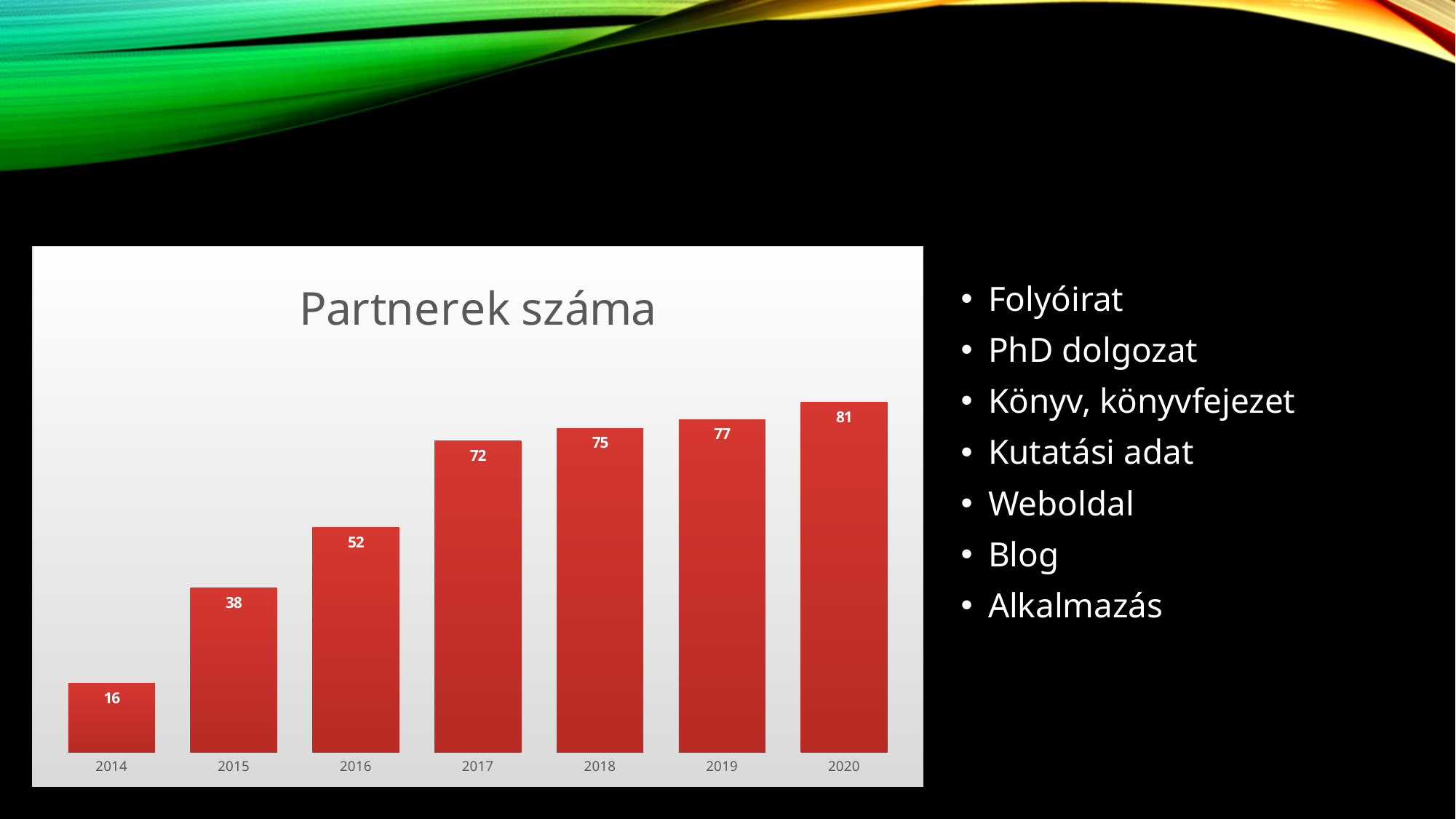
Do the values rise or fall from 2014 to 2020? rise Which is larger, the value for 2018 or the value for 2016? 2018 Which year has the highest value? 2020 What is the difference between the values for 2016 and 2015? 14 What is the value for 2017? 72 What kind of chart is this? bar chart How many years are shown on the x axis? 7 Which year has the lowest value? 2014 What is the title of the chart? Partnerek száma What is the value for 2020? 81 What is the value for 2014? 16 What is the difference between the values for 2020 and 2014? 65